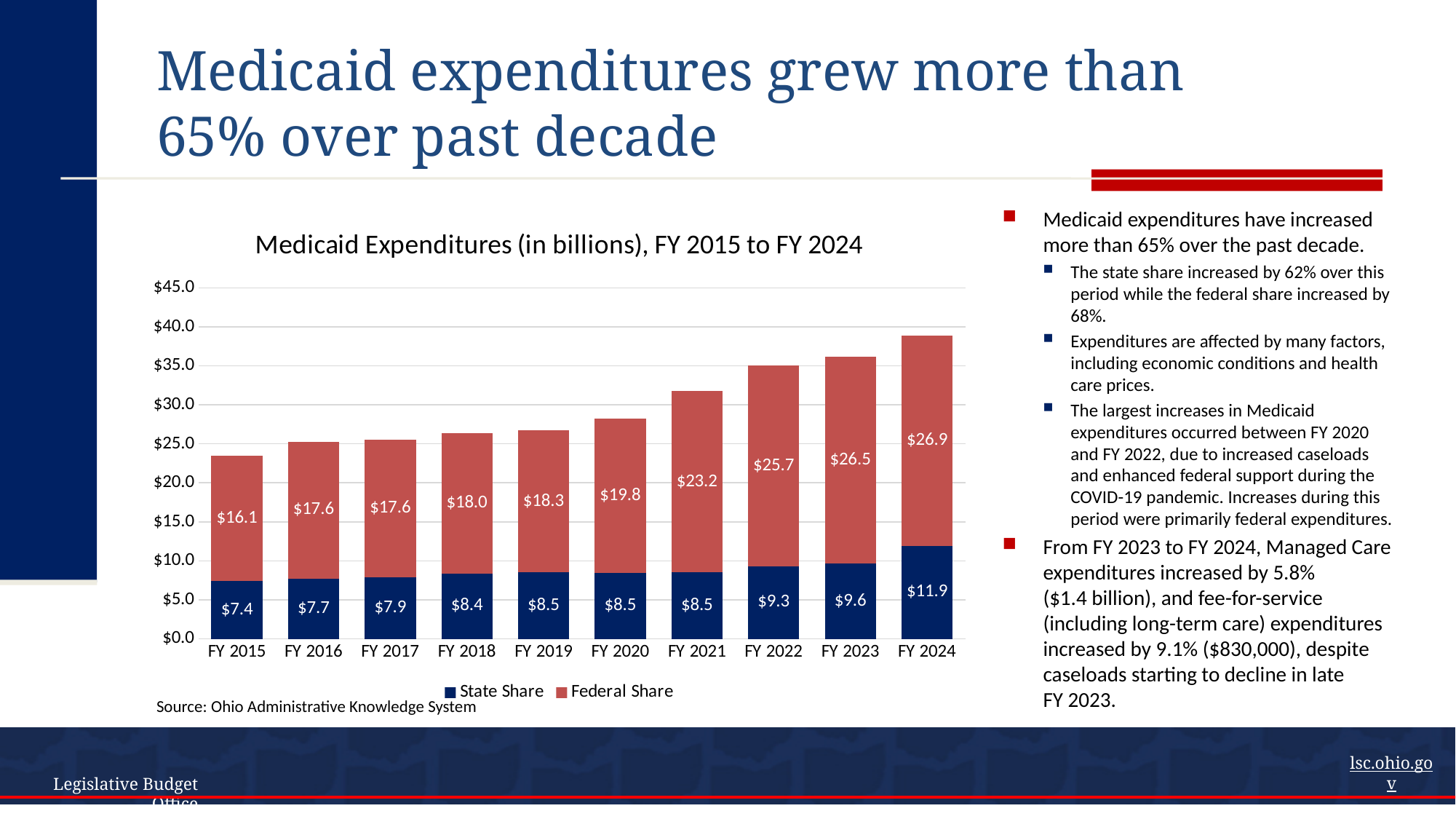
Is the total Medicaid expenditure for FY 2024 greater or less than $35.0? greater What kind of chart is shown on the slide? Stacked bar chart What is the difference between the Federal Share in FY 2024 and FY 2015? $10.8 What is the Federal Share value for FY 2015? $16.1 Which fiscal year has the highest Federal Share? FY 2024 What is the State Share value for FY 2024? $11.9 Which is larger, the State Share in FY 2023 or the State Share in FY 2022? FY 2023 What is the Federal Share value for FY 2021? $23.2 Which fiscal year has the lowest State Share? FY 2015 How many fiscal years are shown on the x axis? 10 What is the total Medicaid expenditure for FY 2015 (State Share plus Federal Share)? $23.5 How many series does the legend list? 2